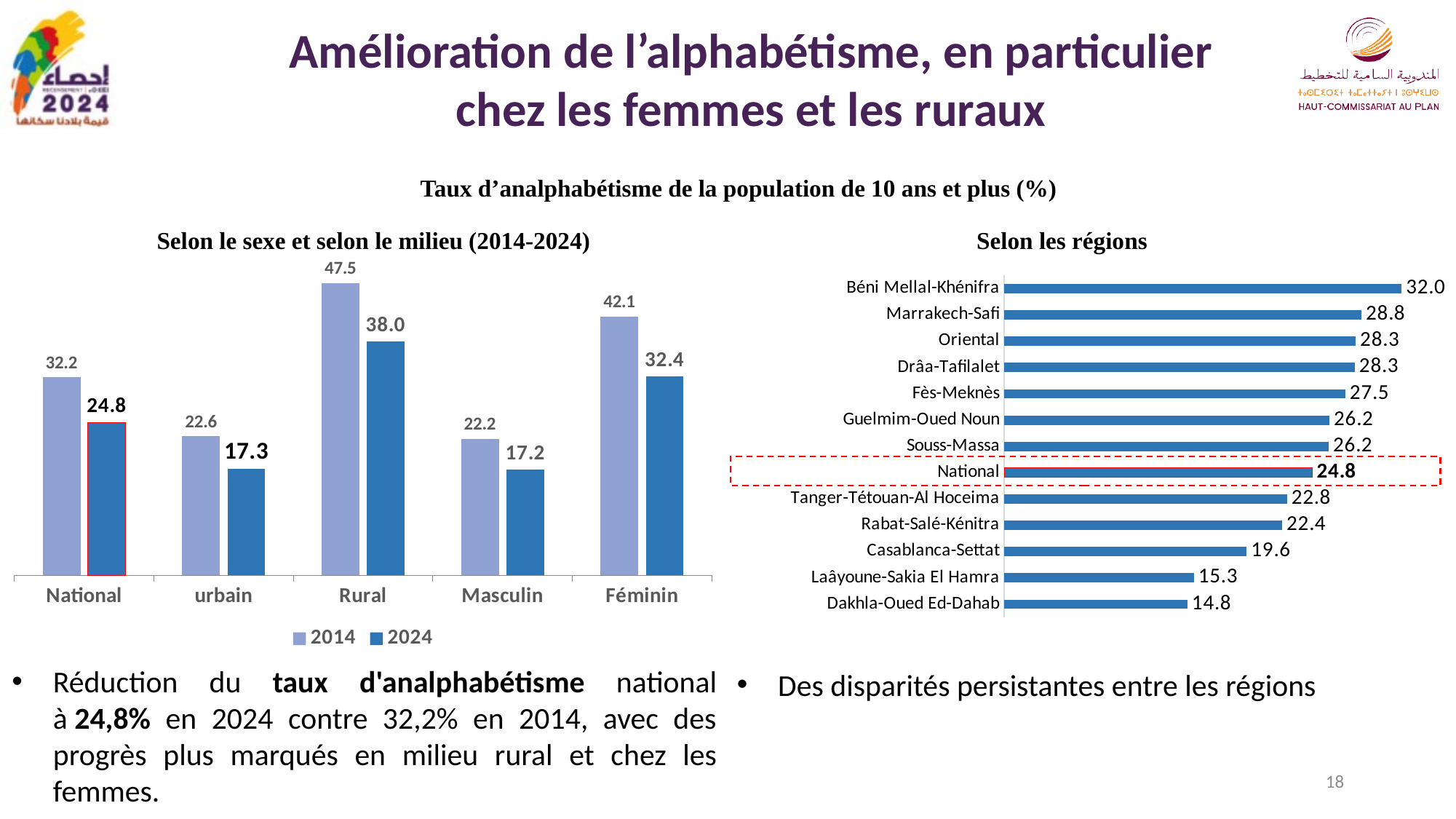
What kind of chart is 'Selon les régions'? Bar chart In the chart 'Selon le sexe et selon le milieu (2014-2024)', what is the difference between the National values for 2014 and 2024? 7.4 In the chart 'Selon le sexe et selon le milieu (2014-2024)', how many series does the legend list? 2 In the chart 'Selon le sexe et selon le milieu (2014-2024)', which category has the lowest 2024 value? Masculin In the chart 'Selon le sexe et selon le milieu (2014-2024)', what is the value for Rural in 2024? 38.0 In the chart 'Selon les régions', which region has the lowest value? Dakhla-Oued Ed-Dahab In the chart 'Selon le sexe et selon le milieu (2014-2024)', what is the value for Féminin in 2014? 42.1 In the chart 'Selon les régions', which is larger: the value for Marrakech-Safi or the value for Fès-Meknès? Marrakech-Safi In the chart 'Selon les régions', what is the value for Casablanca-Settat? 19.6 In the chart 'Selon les régions', which region has the highest value? Béni Mellal-Khénifra In the chart 'Selon le sexe et selon le milieu (2014-2024)', how many categories are shown on the x axis? 5 In the chart 'Selon le sexe et selon le milieu (2014-2024)', which category has the highest 2014 value? Rural